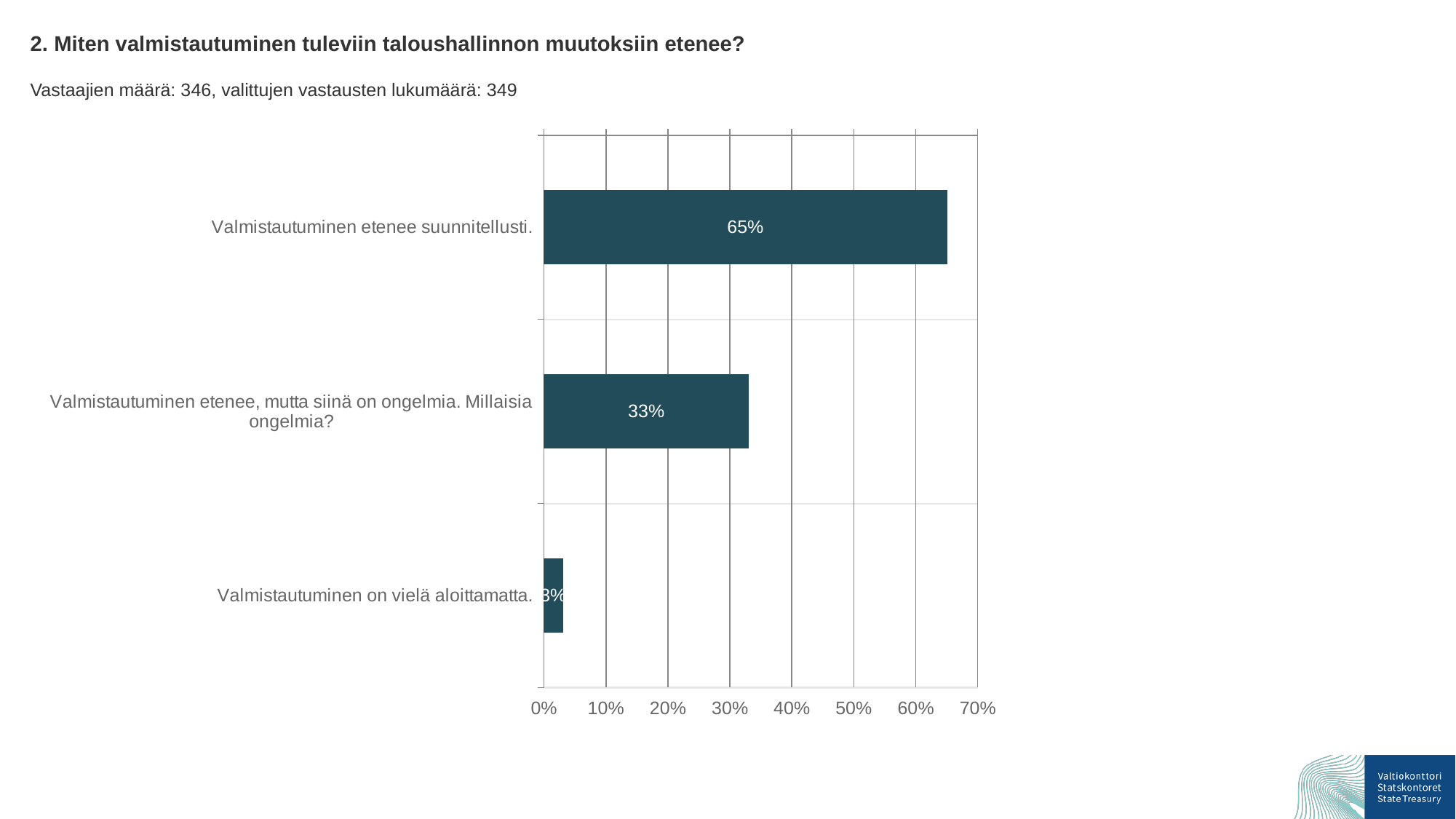
Which category has the lowest value? Valmistautuminen on vielä aloittamatta. What kind of chart is shown on the slide? Bar chart Is the value for "Valmistautuminen etenee, mutta siinä on ongelmia. Millaisia ongelmia?" greater or less than 40%? less What percentage is shown for "Valmistautuminen etenee suunnitellusti."? 65% What is the difference between the values for "Valmistautuminen etenee suunnitellusti." and "Valmistautuminen etenee, mutta siinä on ongelmia. Millaisia ongelmia?"? 32% Is the value for "Valmistautuminen etenee suunnitellusti." greater or less than 60%? greater Which is larger: the value for "Valmistautuminen etenee, mutta siinä on ongelmia. Millaisia ongelmia?" or the value for "Valmistautuminen on vielä aloittamatta."? Valmistautuminen etenee, mutta siinä on ongelmia. Millaisia ongelmia? Which category has the highest value? Valmistautuminen etenee suunnitellusti. What percentage is shown for "Valmistautuminen etenee, mutta siinä on ongelmia. Millaisia ongelmia?"? 33% What is the maximum value shown on the x axis of the chart? 70% What percentage is shown for "Valmistautuminen on vielä aloittamatta."? 3% How many categories are shown in the chart? 3